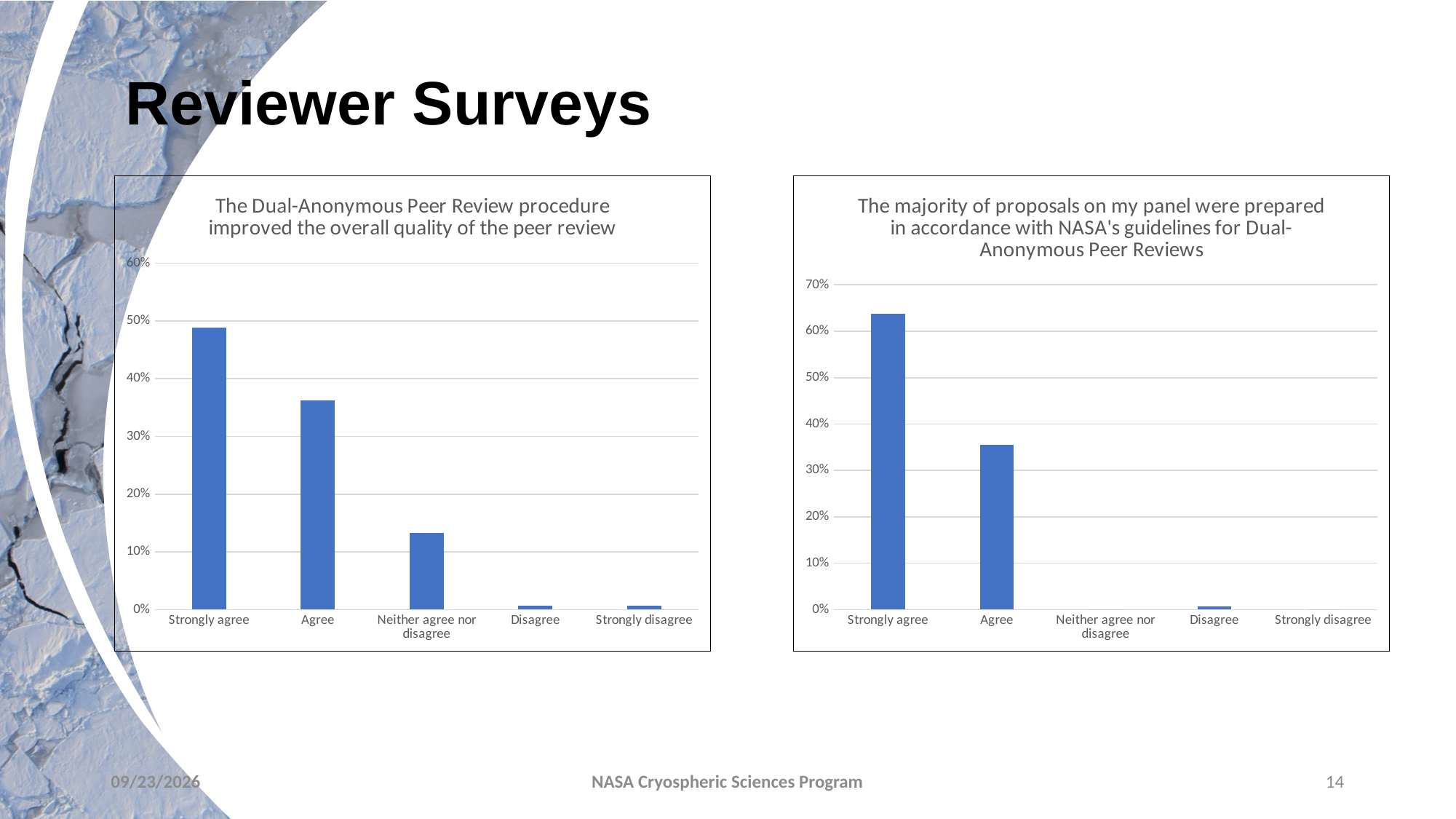
In the left chart (Dual-Anonymous Peer Review procedure improved the overall quality), is the value for Neither agree nor disagree greater or less than 20%? less In the left chart (Dual-Anonymous Peer Review procedure improved the overall quality), which response category has the highest value? Strongly agree In the right chart (majority of proposals on my panel were prepared in accordance with NASA's guidelines), which response category has the highest value? Strongly agree What is the highest value shown on the y axis of the right chart (majority of proposals on my panel were prepared in accordance with NASA's guidelines)? 70% In the left chart (Dual-Anonymous Peer Review procedure improved the overall quality), how many response categories are shown on the x axis? 5 In the right chart (majority of proposals on my panel were prepared in accordance with NASA's guidelines), is the value for Agree greater or less than 40%? less What kind of chart is the left chart, titled 'The Dual-Anonymous Peer Review procedure improved the overall quality of the peer review'? bar chart In the left chart (Dual-Anonymous Peer Review procedure improved the overall quality), which is larger, the value for Agree or the value for Neither agree nor disagree? Agree In the right chart (majority of proposals on my panel were prepared in accordance with NASA's guidelines), is the value for Strongly agree greater or less than 60%? greater In the right chart (majority of proposals on my panel were prepared in accordance with NASA's guidelines), do the values generally rise or fall moving from Strongly agree to Strongly disagree along the x axis? fall In the right chart (majority of proposals on my panel were prepared in accordance with NASA's guidelines), which is larger, the value for Strongly agree or the value for Agree? Strongly agree